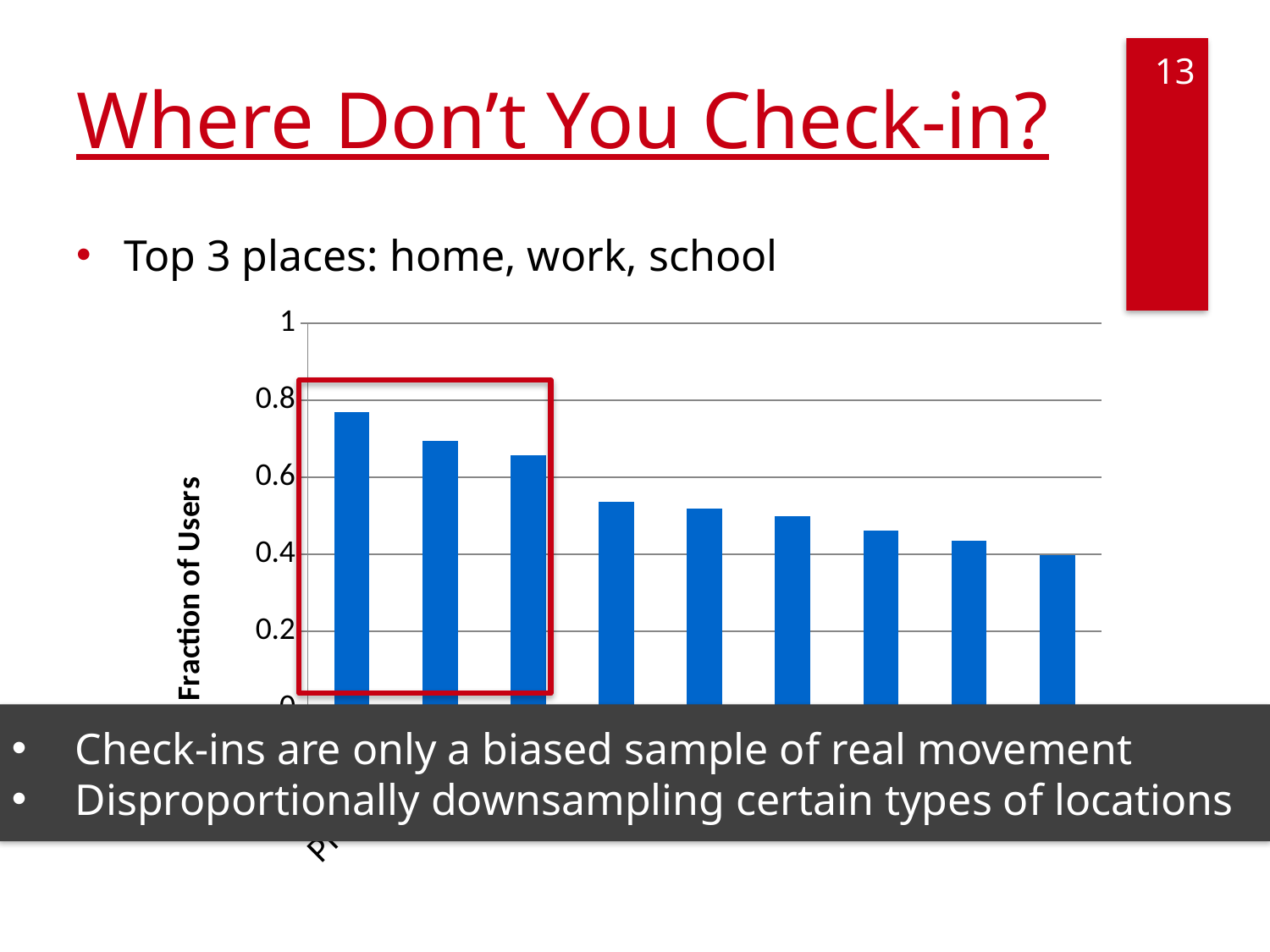
Is the value of the third bar from the left greater or less than 0.6? greater Is the value of the first (leftmost) bar greater or less than 0.6? greater How many bars are plotted in the chart? 9 Which bar has the lowest value in the chart? the rightmost (last) bar Is the value of the first (leftmost) bar greater or less than 0.8? less What kind of chart is shown on the slide? bar chart What is the label of the vertical axis of the chart? Fraction of Users Which bar has the highest value in the chart? the leftmost (first) bar Which is larger, the value of the first bar or the value of the fourth bar? the first bar Do the bar values rise or fall from left to right across the chart? fall How many bars are enclosed by the red box in the chart? 3